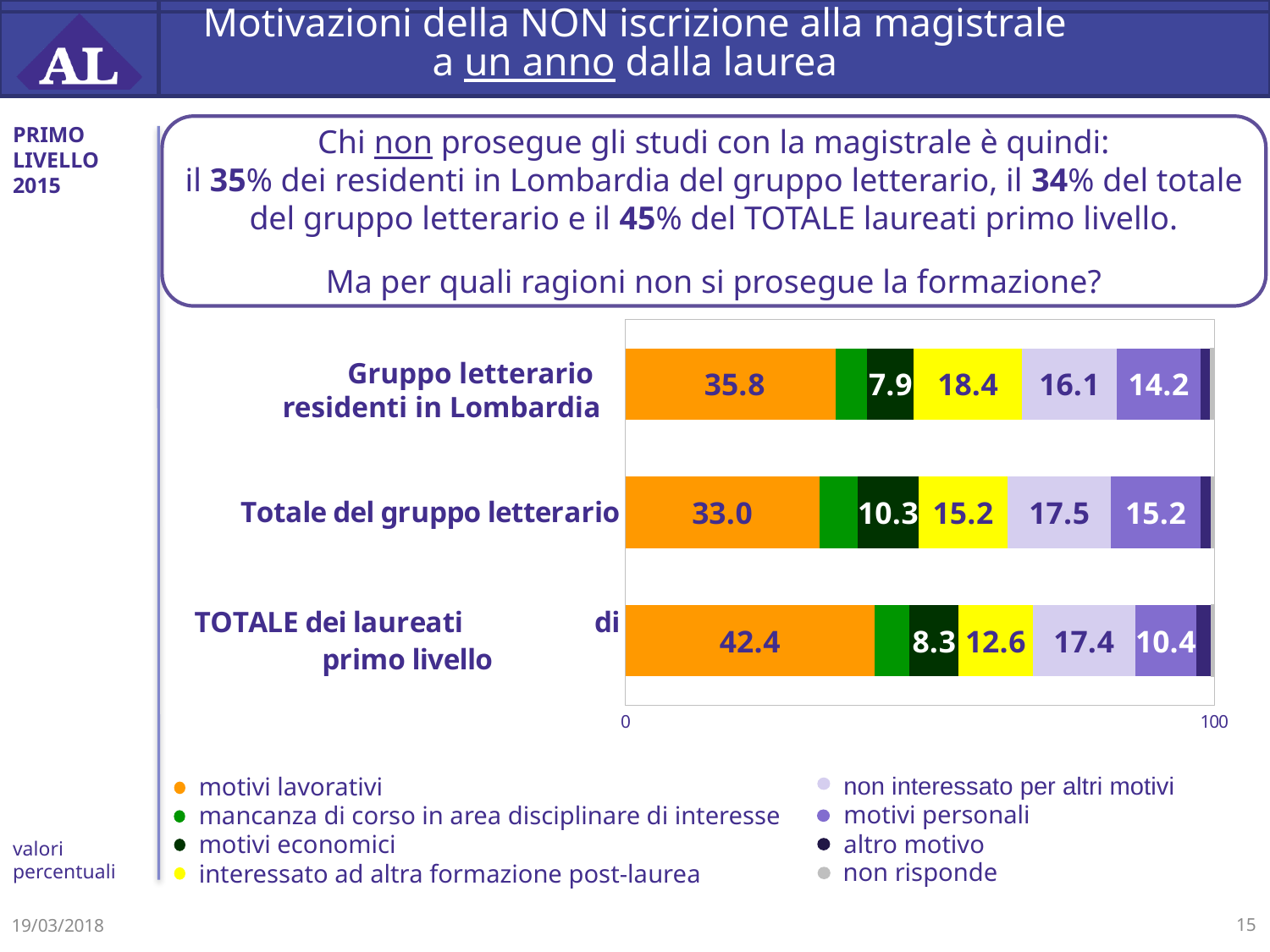
What is the maximum value shown on the horizontal axis? 100 For 'motivi personali', which is larger: 'Gruppo letterario residenti in Lombardia' or 'Totale del gruppo letterario'? Totale del gruppo letterario What is the value for 'interessato ad altra formazione post-laurea' in the 'Gruppo letterario residenti in Lombardia' bar? 18.4 Which category has the highest value for 'motivi lavorativi'? TOTALE dei laureati di primo livello How many series does the legend list? 8 How many categories (bars) does the chart show? 3 Which category has the lowest value for 'motivi personali'? TOTALE dei laureati di primo livello What kind of chart is shown on the slide? Stacked bar chart What is the value for 'non interessato per altri motivi' in the 'Totale del gruppo letterario' bar? 17.5 What is the difference in 'motivi lavorativi' between 'TOTALE dei laureati di primo livello' and 'Gruppo letterario residenti in Lombardia'? 6.6 What is the value for 'motivi lavorativi' in the 'Totale del gruppo letterario' bar? 33.0 What is the value for 'motivi lavorativi' in the 'TOTALE dei laureati di primo livello' bar? 42.4